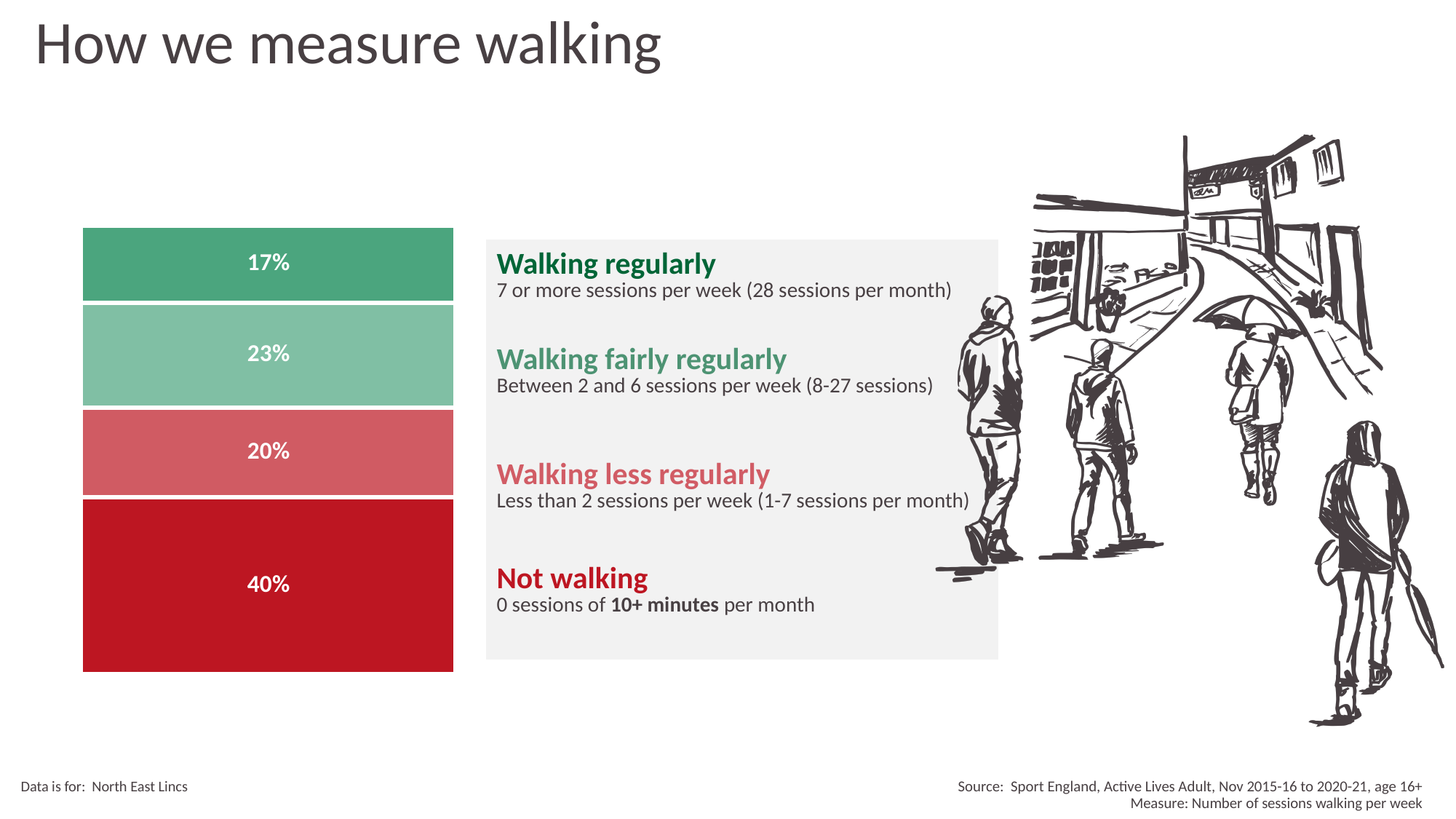
How many walking categories are shown in the stacked bar? 4 Which walking category has the largest share? Not walking What percentage of people are 'Walking less regularly'? 20% What is the difference in percentage points between 'Not walking' and 'Walking regularly'? 23 What percentage of people are 'Walking regularly'? 17% What percentage of people are in the 'Not walking' category? 40% What percentage of people are 'Walking fairly regularly'? 23% What kind of chart is shown on the slide? Stacked bar chart What is the total of all the segments in the stacked bar? 100% What colour is the 'Not walking' segment of the bar? Red Which walking category has the smallest share? Walking regularly Which is larger: the share for 'Walking fairly regularly' or 'Walking less regularly'? Walking fairly regularly